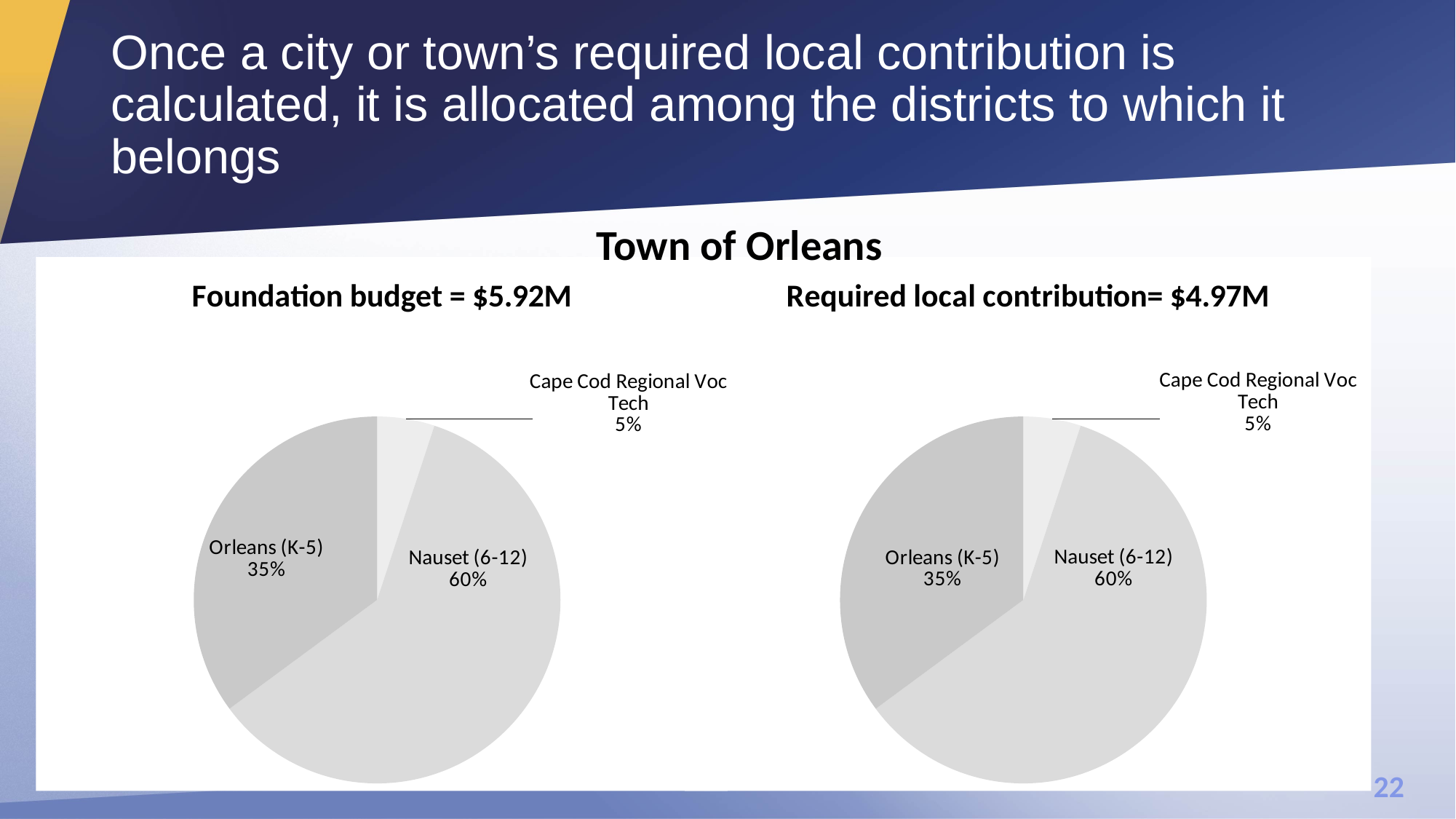
How many slices does the 'Foundation budget = $5.92M' chart have? 3 In the 'Foundation budget = $5.92M' chart, what share does Orleans (K-5) have? 35% In the 'Required local contribution= $4.97M' chart, what share does Nauset (6-12) have? 60% In the 'Foundation budget = $5.92M' chart, what share does Nauset (6-12) have? 60% What kind of chart is the 'Required local contribution= $4.97M' chart? Pie chart In the 'Foundation budget = $5.92M' chart, what is the difference in percentage points between Nauset (6-12) and Orleans (K-5)? 25 In the 'Required local contribution= $4.97M' chart, which is larger: Orleans (K-5) or Cape Cod Regional Voc Tech? Orleans (K-5) What is the overall title above the two charts? Town of Orleans In the 'Foundation budget = $5.92M' chart, which district has the largest slice? Nauset (6-12) What is the title of the chart on the left? Foundation budget = $5.92M In the 'Required local contribution= $4.97M' chart, which district has the smallest slice? Cape Cod Regional Voc Tech